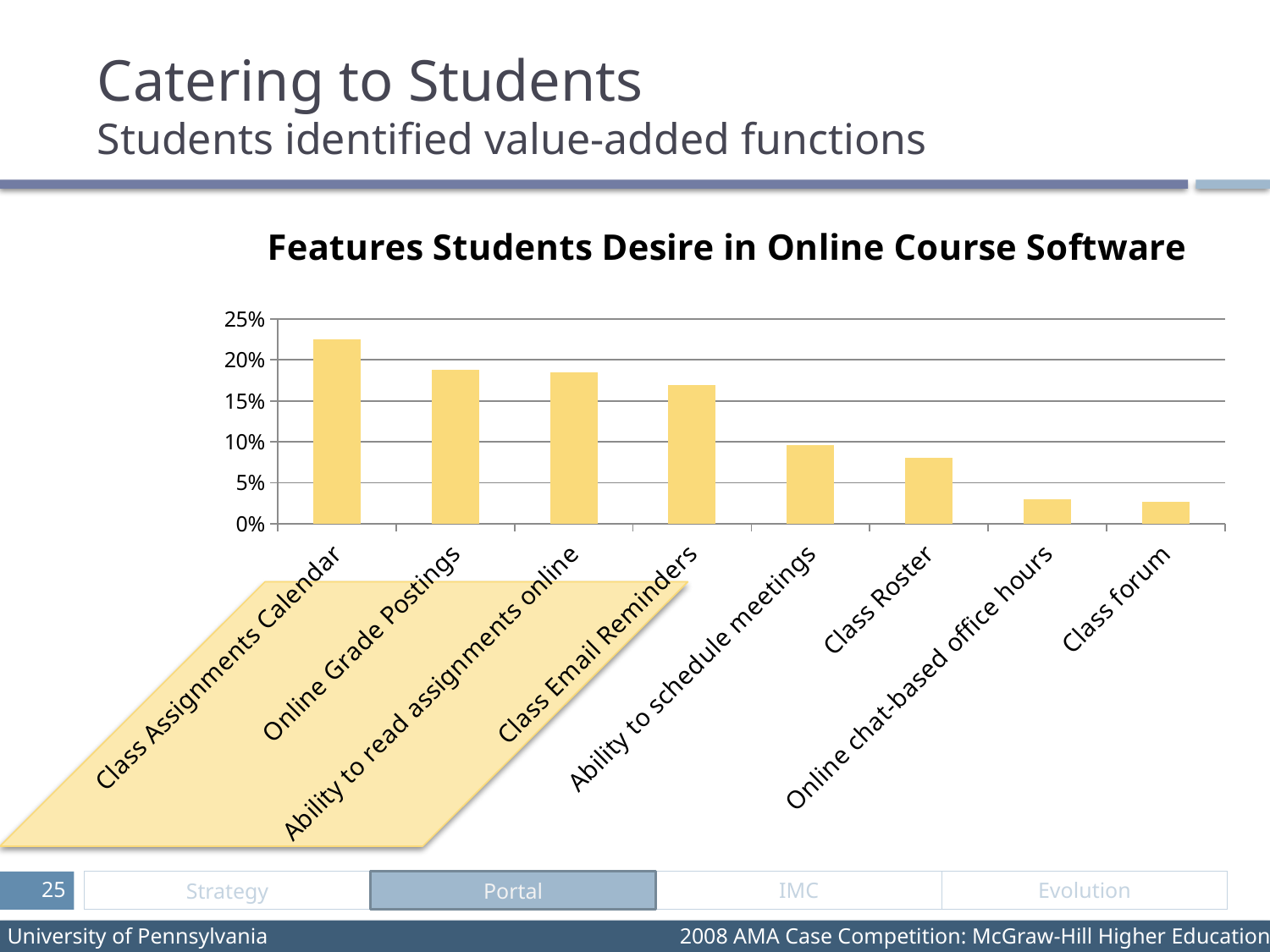
Which is larger, the value for Online Grade Postings or the value for Class Roster? Online Grade Postings What kind of chart is shown on the slide? Bar chart Is the value for Class Assignments Calendar greater or less than 20%? greater Which feature has the highest value in the chart? Class Assignments Calendar Which is larger, the value for Ability to schedule meetings or the value for Online chat-based office hours? Ability to schedule meetings Is the value for Class Email Reminders greater or less than 15%? greater Is the value for Ability to schedule meetings greater or less than 15%? less How many features (categories) are plotted in the chart? 8 What is the title of the chart? Features Students Desire in Online Course Software Do the bar values rise or fall from left to right across the chart? Fall